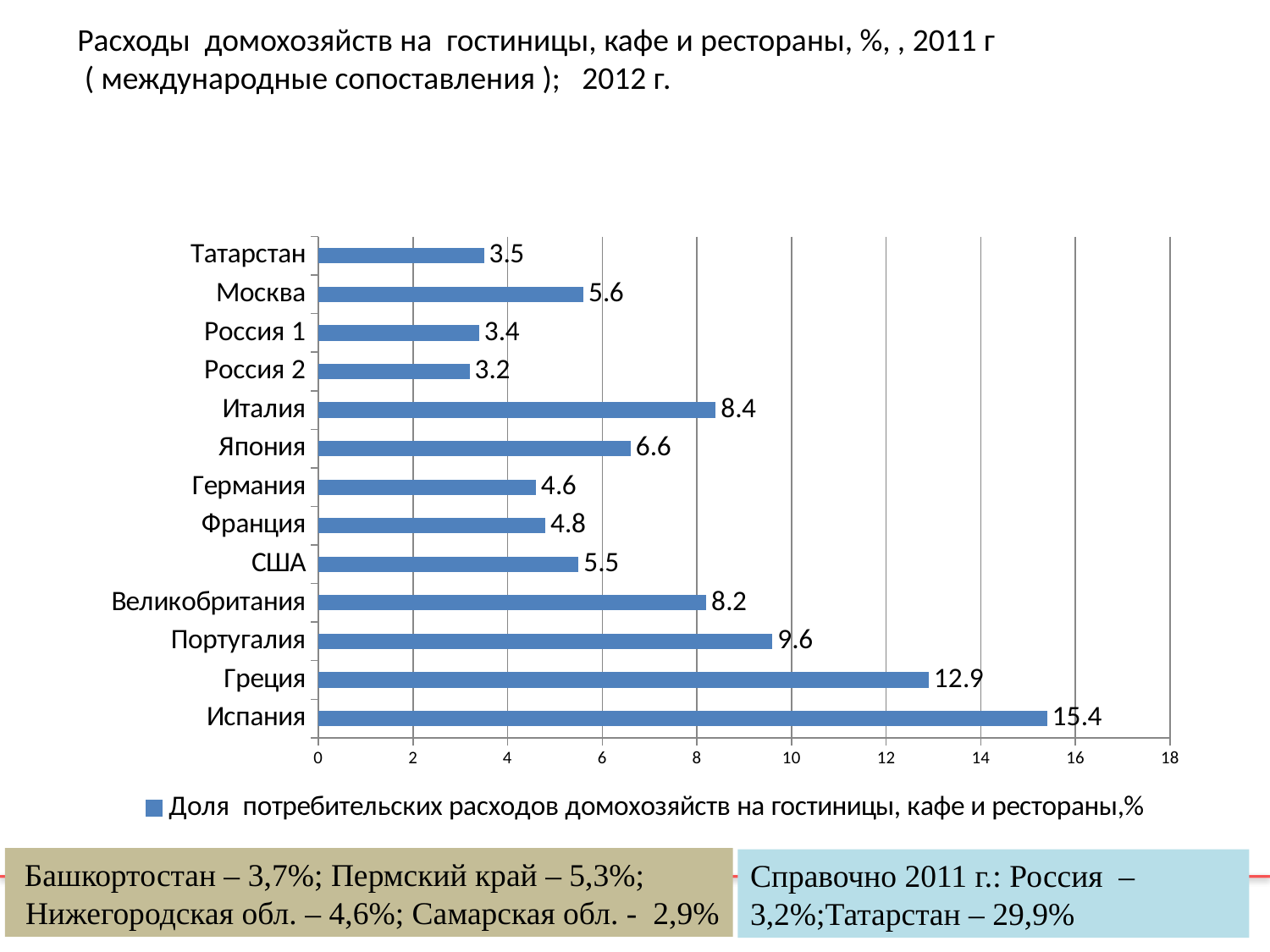
What is the value for Татарстан? 3.5 What kind of chart is shown? Bar chart What is the legend entry for the series? Доля потребительских расходов домохозяйств на гостиницы, кафе и рестораны,% Which category has the lowest value? Россия 2 Which is larger, the value for Италия or the value for Великобритания? Италия What is the value for Япония? 6.6 Which is larger, the value for Москва or the value for США? Москва What is the difference between the values for Греция and Португалия? 3.3 Which category has the highest value? Испания How many series does the legend list? 1 What is the value for Испания? 15.4 How many categories are shown on the chart? 13